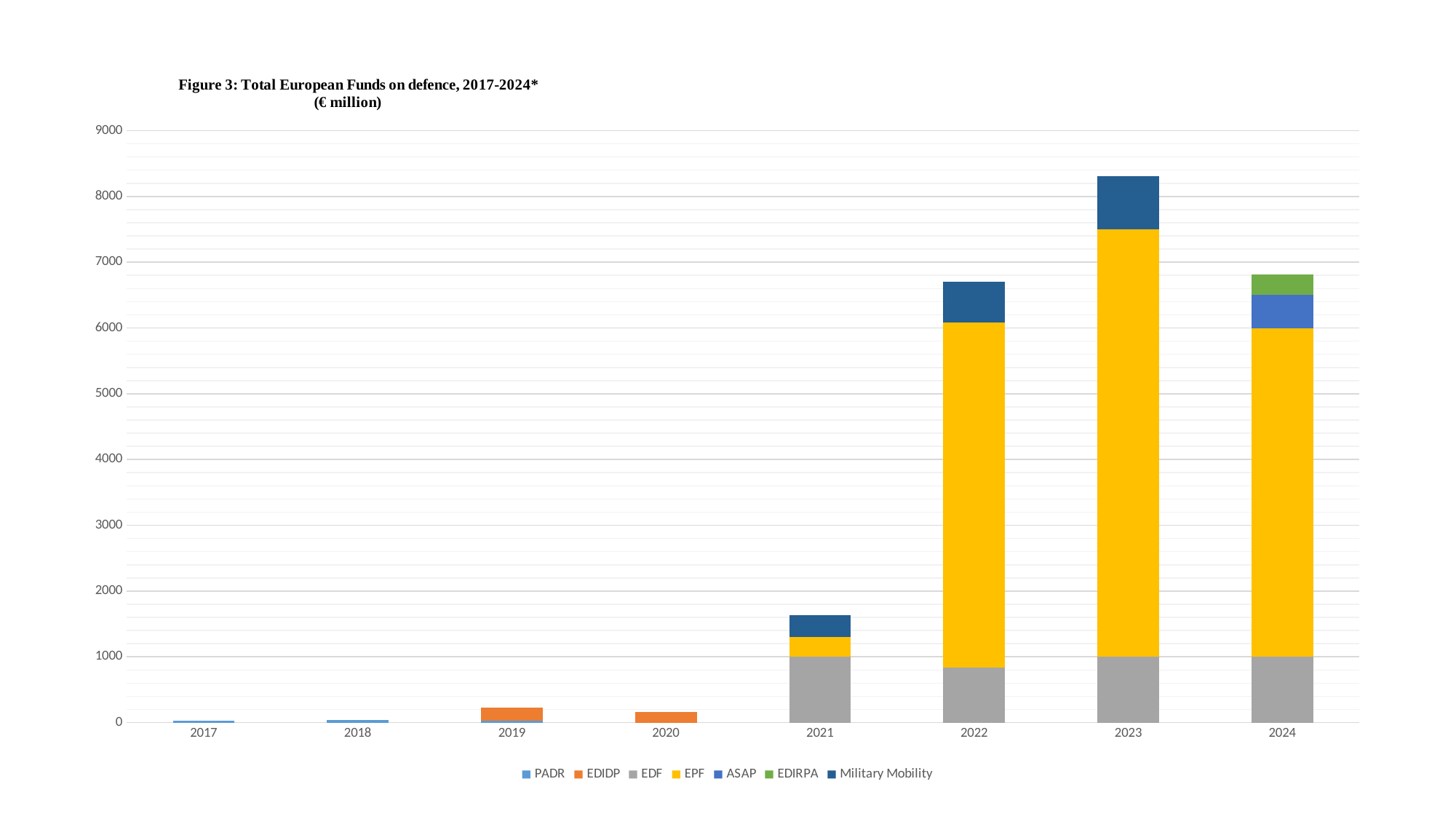
Which series is shown in yellow in the legend? EPF How many series does the legend list? 7 What kind of chart is shown on the slide? Stacked bar chart Which year has the larger total, 2022 or 2023? 2023 Is the total for 2021 greater or less than 2000? less How many years are shown on the x axis of the chart? 8 Is the total for 2023 greater or less than 8000? greater Is the total for 2019 greater or less than 1000? less Which year has the highest total stacked bar? 2023 Do the total bars generally rise or fall from 2017 to 2023? rise What is the title of the chart? Figure 3: Total European Funds on defence, 2017-2024* (€ million)